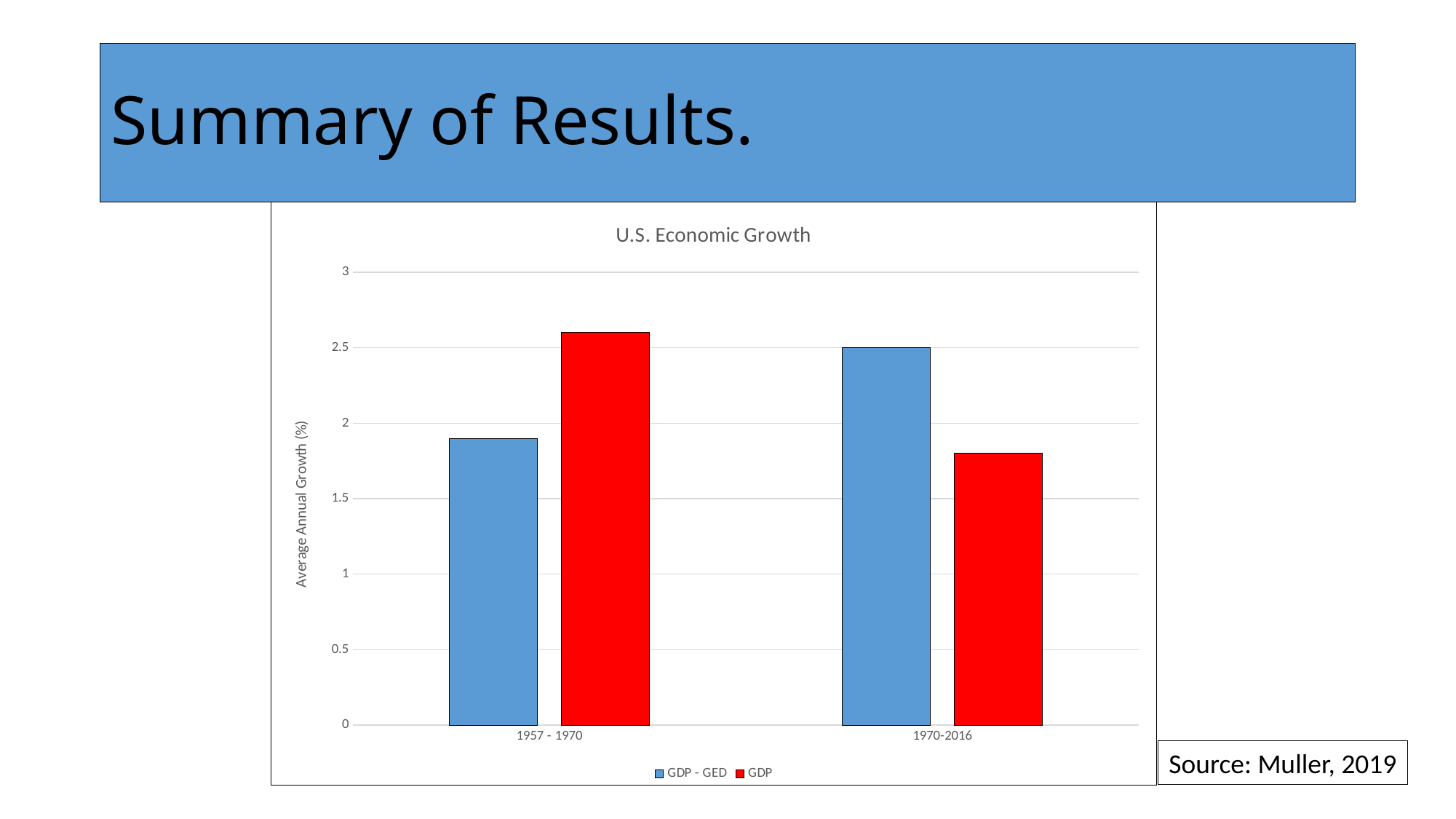
In the 1957 - 1970 period, which series has the larger value, GDP - GED or GDP? GDP Which series is shown in red? GDP Is the value for GDP in 1970-2016 greater or less than 2? less What is the title of the chart? U.S. Economic Growth How many time periods are shown on the x axis? 2 Is the value for GDP - GED in 1970-2016 greater or less than 2? greater Is the value for GDP - GED in 1957 - 1970 greater or less than 2? less What type of chart is shown on the slide? Bar chart In the 1970-2016 period, which series has the larger value, GDP - GED or GDP? GDP - GED Does the GDP series rise or fall from 1957 - 1970 to 1970-2016? Fall How many series does the legend list? 2